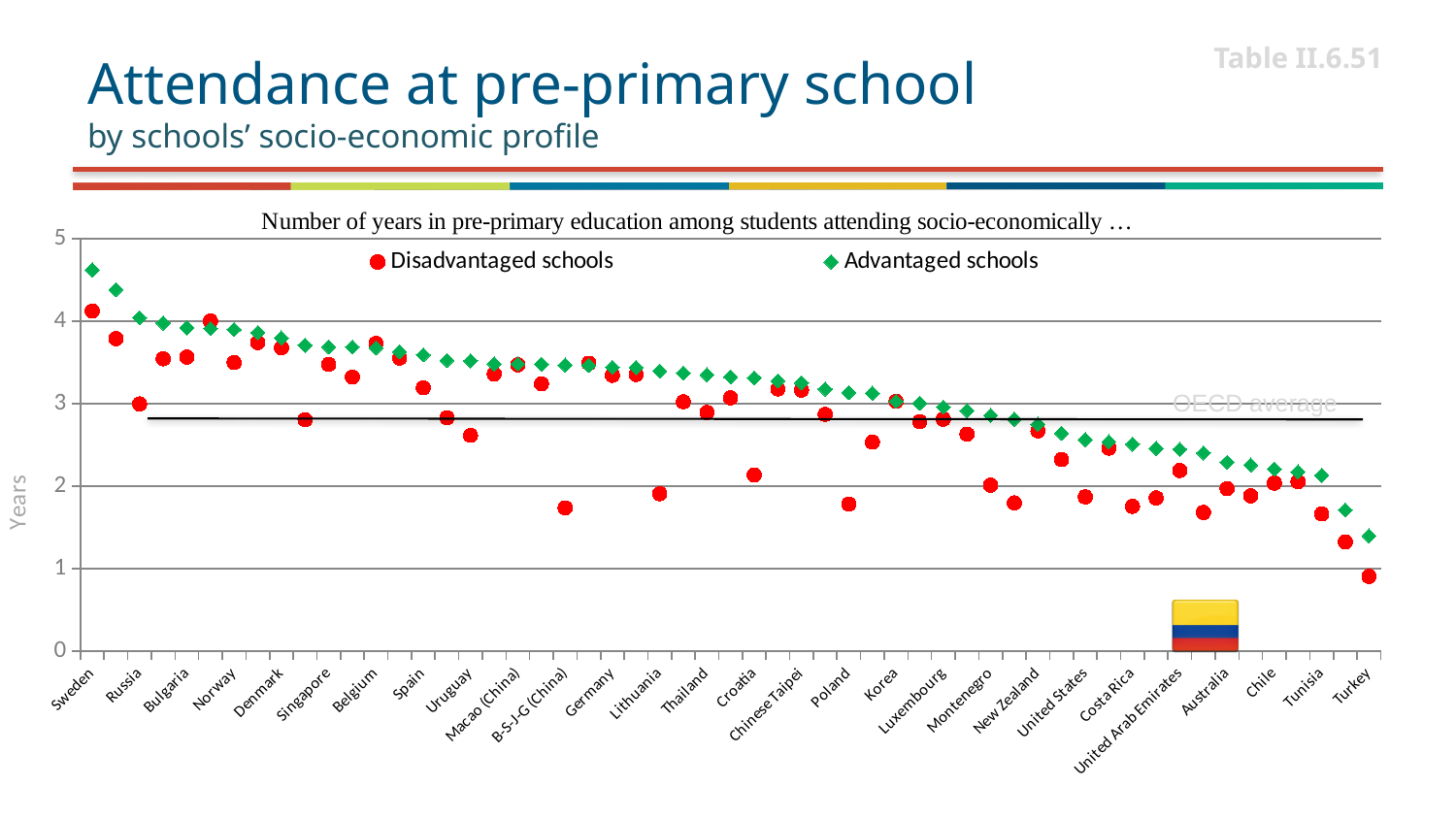
Which country has the lowest value for Advantaged schools? Turkey What kind of chart is shown on the slide? Scatter (dot) chart Is the value for Disadvantaged schools in Turkey greater or less than 1? less For Sweden, which is larger: the value for Advantaged schools or for Disadvantaged schools? Advantaged schools Do the values for Advantaged schools rise or fall moving from left to right along the x axis? fall Is the value for Advantaged schools in Sweden greater or less than 4? greater Is the value for Advantaged schools in Turkey greater or less than 2? less What are the two series shown in the chart's legend? Disadvantaged schools and Advantaged schools How many series does the chart's legend list? 2 Which country has the highest value for Advantaged schools? Sweden Which country has the lowest value for Disadvantaged schools? Turkey